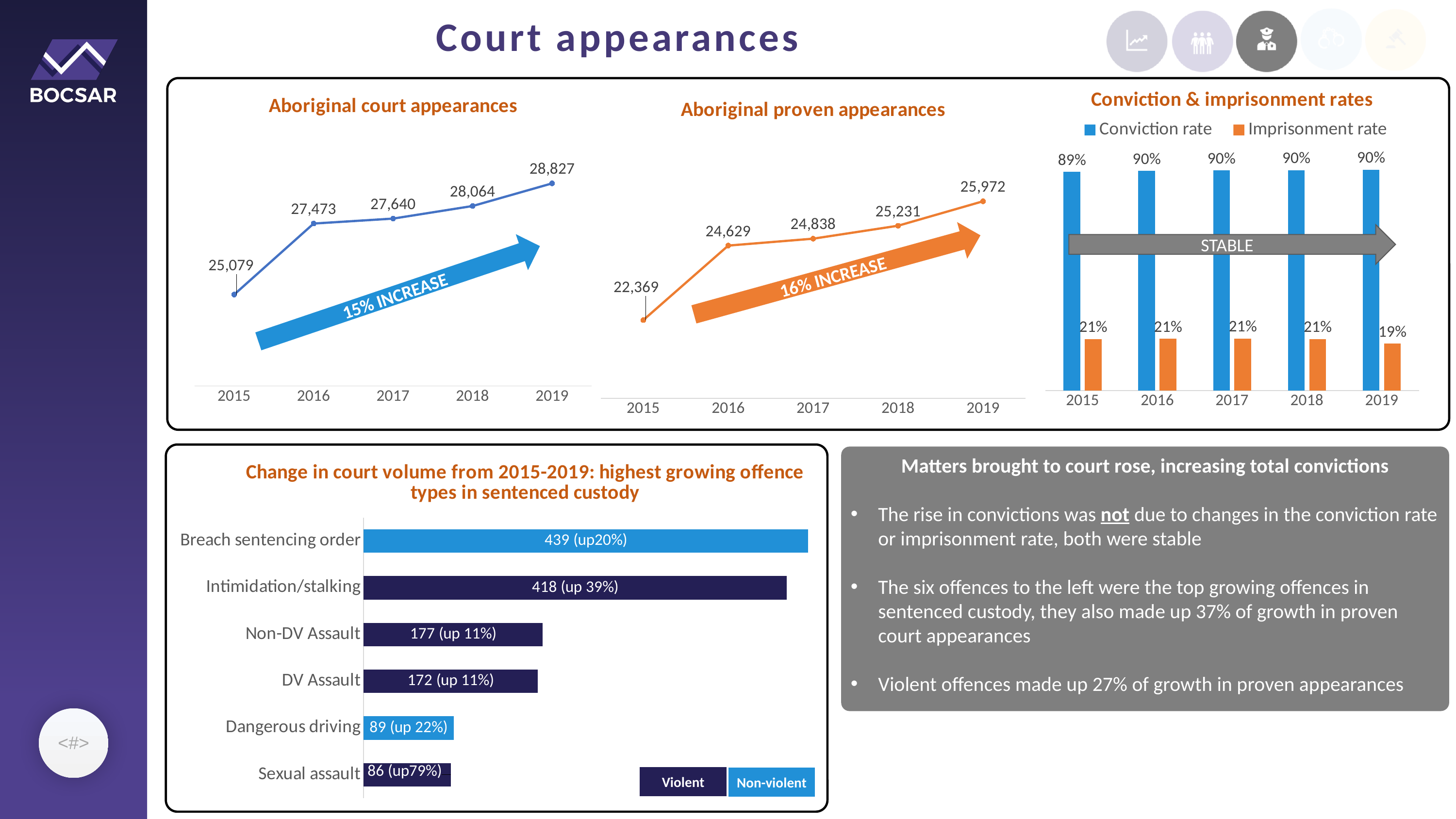
In the 'Aboriginal proven appearances' chart, do the values rise or fall from 2015 to 2019? rise In the 'Change in court volume from 2015-2019' chart, what is the value for Dangerous driving? 89 (up 22%) In the 'Conviction & imprisonment rates' chart, what is the imprisonment rate for 2019? 19% In the 'Aboriginal proven appearances' chart, how many years are plotted? 5 In the 'Conviction & imprisonment rates' chart, what is the conviction rate for 2015? 89% What kind of chart is the 'Change in court volume from 2015-2019' chart? bar chart In the 'Aboriginal proven appearances' chart, what is the value for 2017? 24,838 In the 'Change in court volume from 2015-2019' chart, which offence type has the highest value? Breach sentencing order In the 'Aboriginal court appearances' chart, what is the value for 2019? 28,827 In the 'Aboriginal court appearances' chart, which year has the lowest value? 2015 In the 'Conviction & imprisonment rates' chart, how many series does the legend list? 2 In the 'Aboriginal court appearances' chart, what is the difference between the 2019 and 2015 values? 3,748